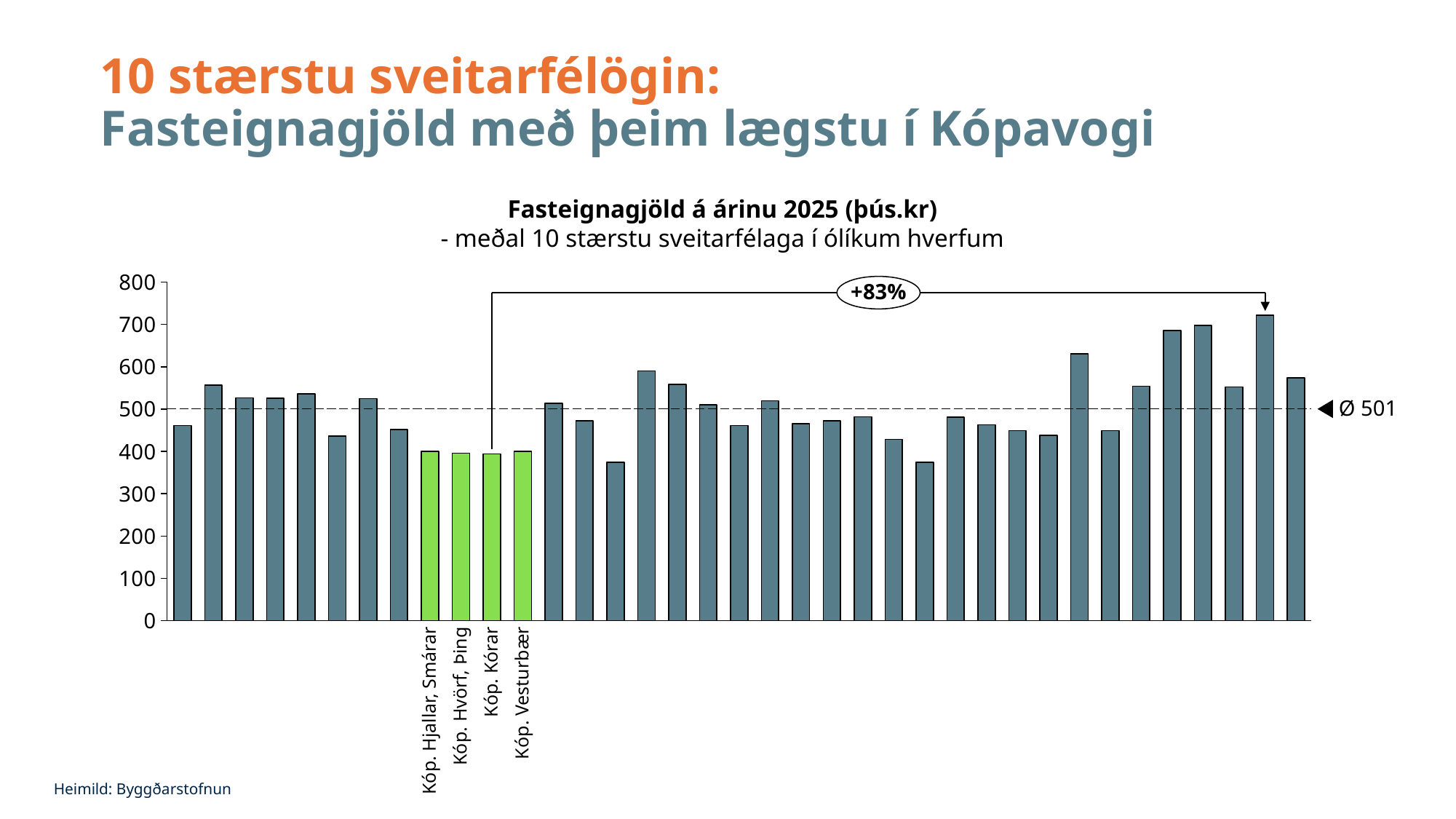
Is the value for Kóp. Hjallar, Smárar greater or less than 300? greater Is the average value marked on the chart greater or less than 500? greater What average value is marked by the dashed line on the chart? Ø 501 How many bars are highlighted in green on the chart? 4 Is the value for Kóp. Vesturbær greater or less than 500? less What kind of chart is shown on the slide? bar chart What is the highest value shown on the vertical axis? 800 What percentage is shown in the annotation above the chart? +83% What is the title of the chart? Fasteignagjöld á árinu 2025 (þús.kr)